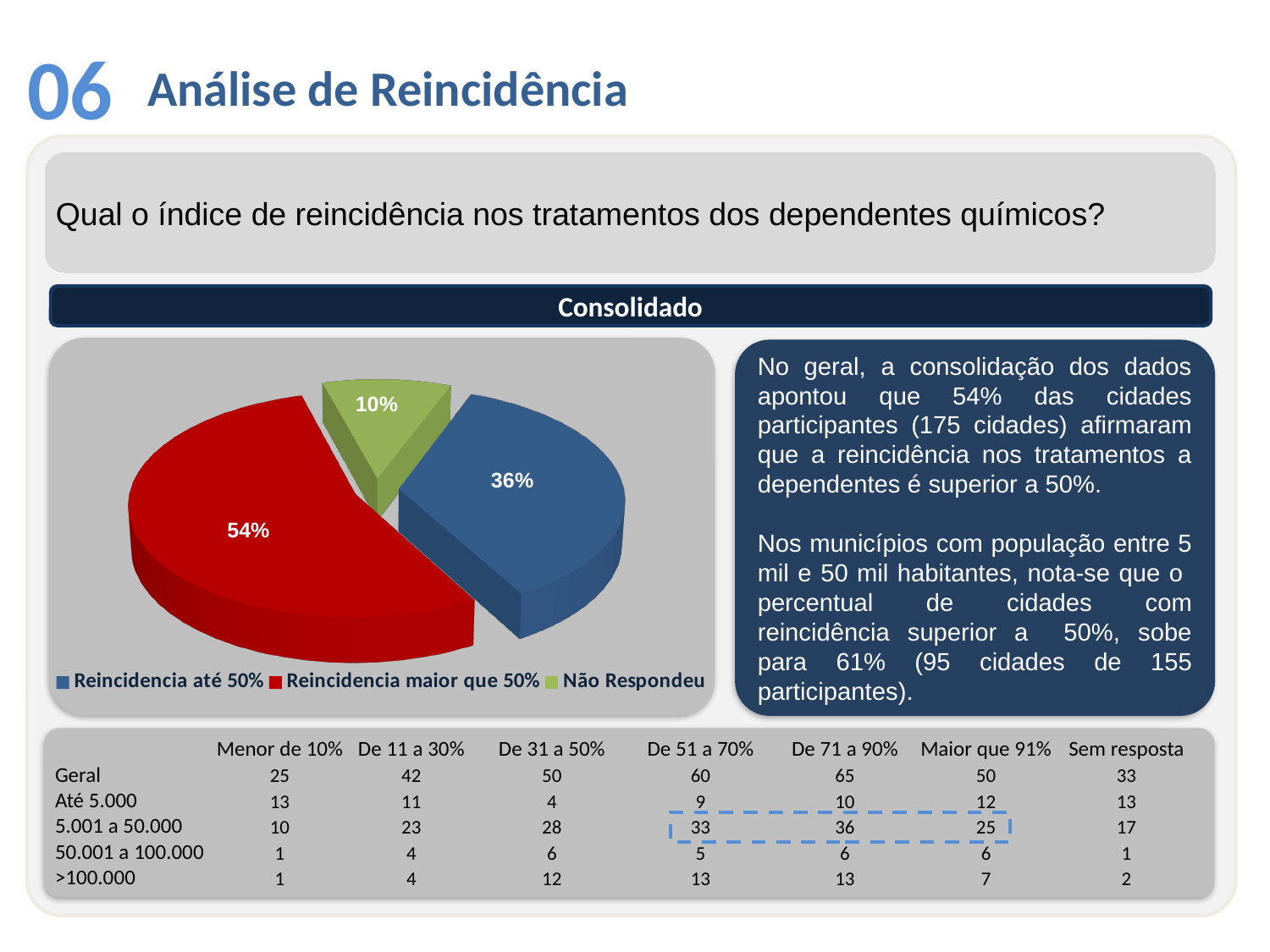
Which slice of the pie chart is the largest? Reincidencia maior que 50% Which is larger in the pie chart: "Reincidencia até 50%" or "Não Respondeu"? Reincidencia até 50% What is the difference in percentage points between "Reincidencia maior que 50%" and "Reincidencia até 50%"? 18 What is the title shown in the banner above the pie chart? Consolidado What colour is the "Reincidencia maior que 50%" slice in the pie chart? red What share of the pie does "Reincidencia maior que 50%" represent? 54% Which slice of the pie chart is the smallest? Não Respondeu What kind of chart is shown on the slide? pie chart How many slices does the pie chart have? 3 How many entries does the pie chart's legend list? 3 What share of the pie does "Reincidencia até 50%" represent? 36% What share of the pie does "Não Respondeu" represent? 10%